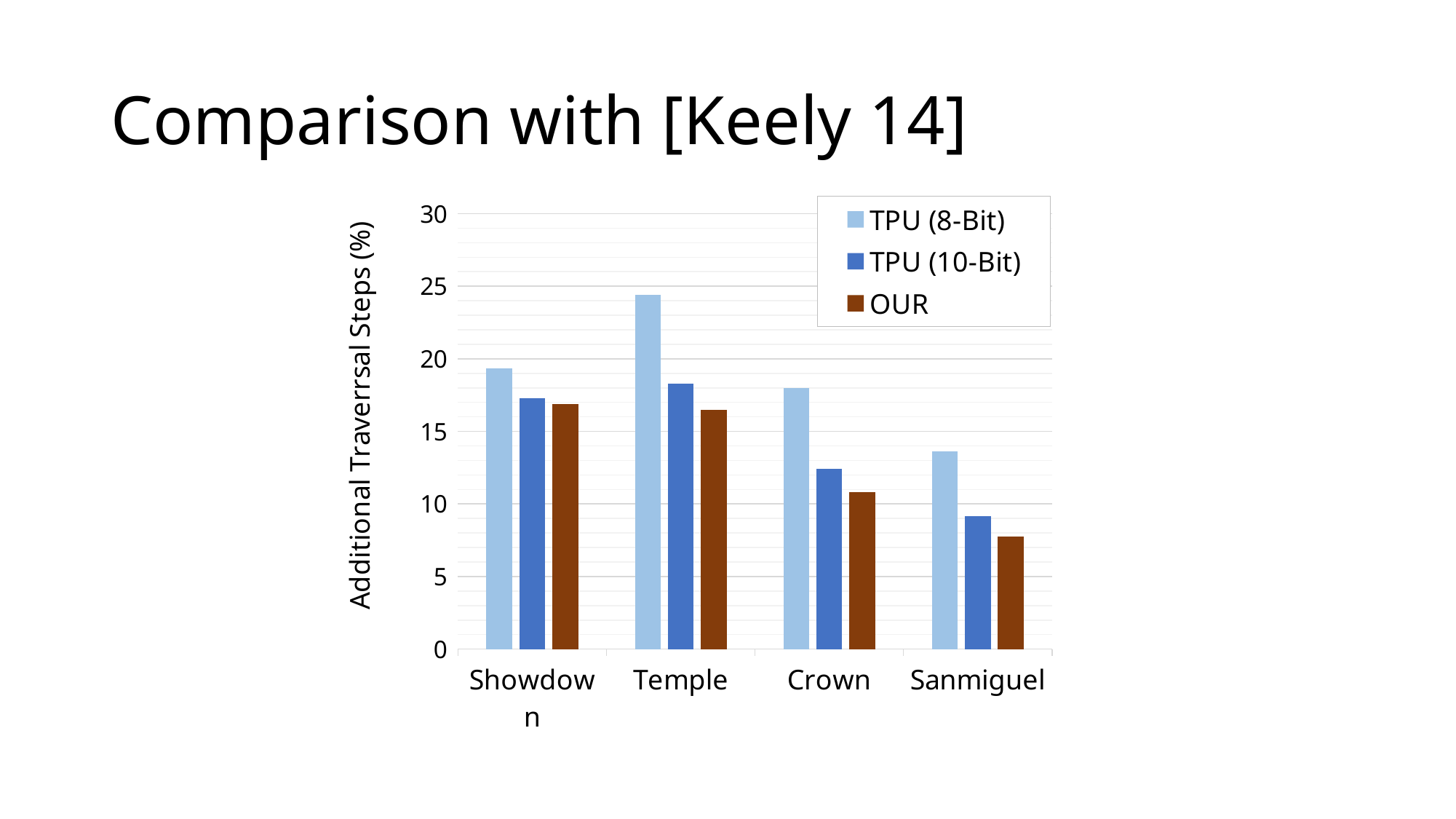
For which scene is the OUR value lowest? Sanmiguel How many series does the legend list? 3 How many scene categories are shown on the x axis? 4 For Crown, which is larger: the TPU (10-Bit) value or the OUR value? TPU (10-Bit) Do the OUR values rise or fall from Showdown to Sanmiguel along the x axis? fall Is the TPU (10-Bit) value for Showdown greater or less than 15? greater For which scene is the TPU (8-Bit) value highest? Temple What kind of chart is shown on the slide? bar chart Is the OUR value for Sanmiguel greater or less than 10? less Is the TPU (8-Bit) value for Temple greater or less than 20? greater Which series has the highest value for Sanmiguel? TPU (8-Bit) What is the label of the y axis? Additional Traverrsal Steps (%)